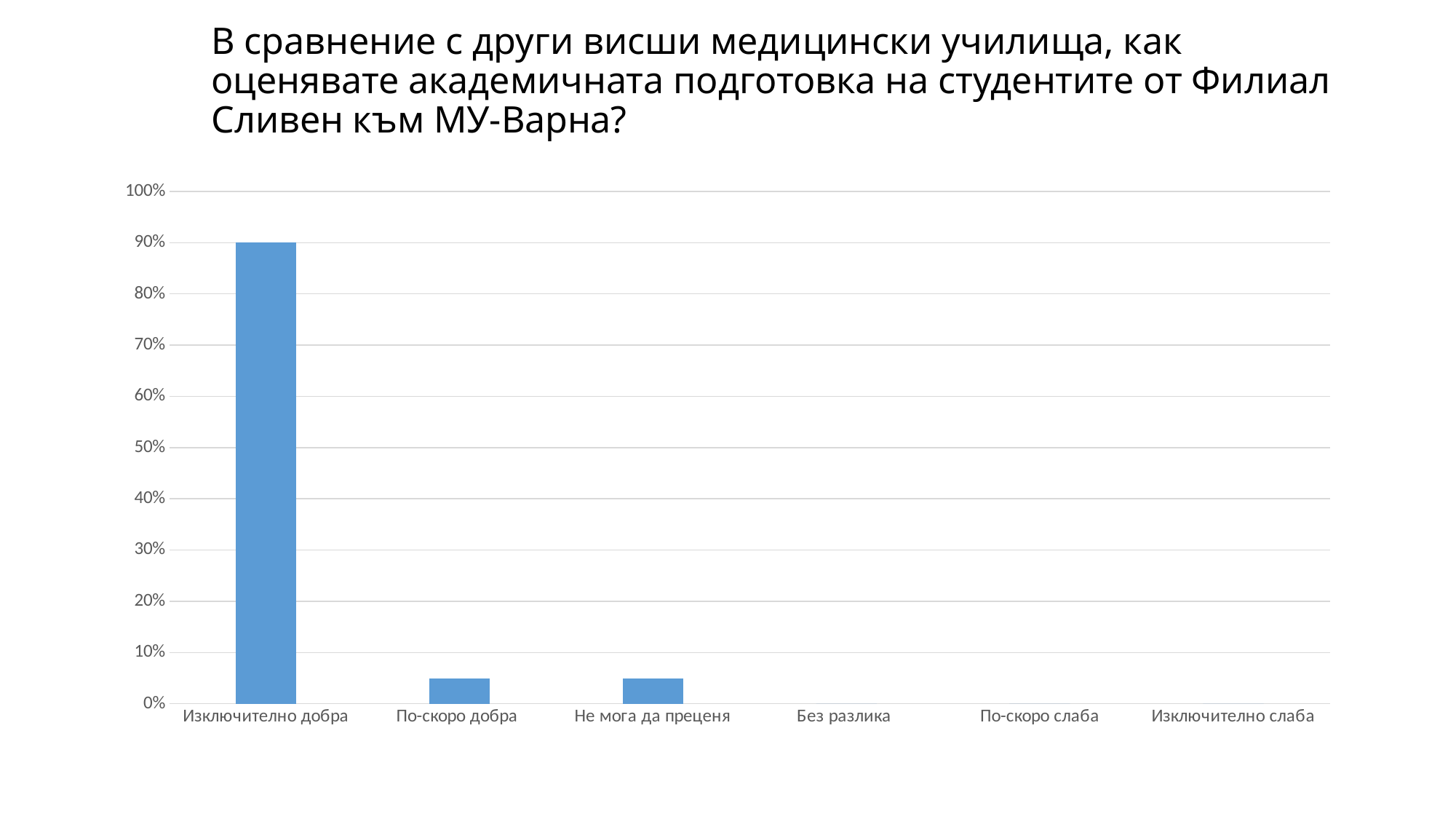
Is the value for Не мога да преценя greater or less than 10%? less What kind of chart is shown on the slide? bar chart What is the value for Изключително добра? 90% Is the value for Изключително добра greater or less than 80%? greater What is the label of the last category on the x axis? Изключително слаба Which category has the highest value? Изключително добра Is the value for По-скоро добра greater or less than 10%? less Which is larger, the value for Не мога да преценя or the value for Без разлика? Не мога да преценя Which is larger, the value for Изключително добра or the value for По-скоро добра? Изключително добра How many categories are shown on the x axis? 6 What is the highest value shown on the y axis? 100%